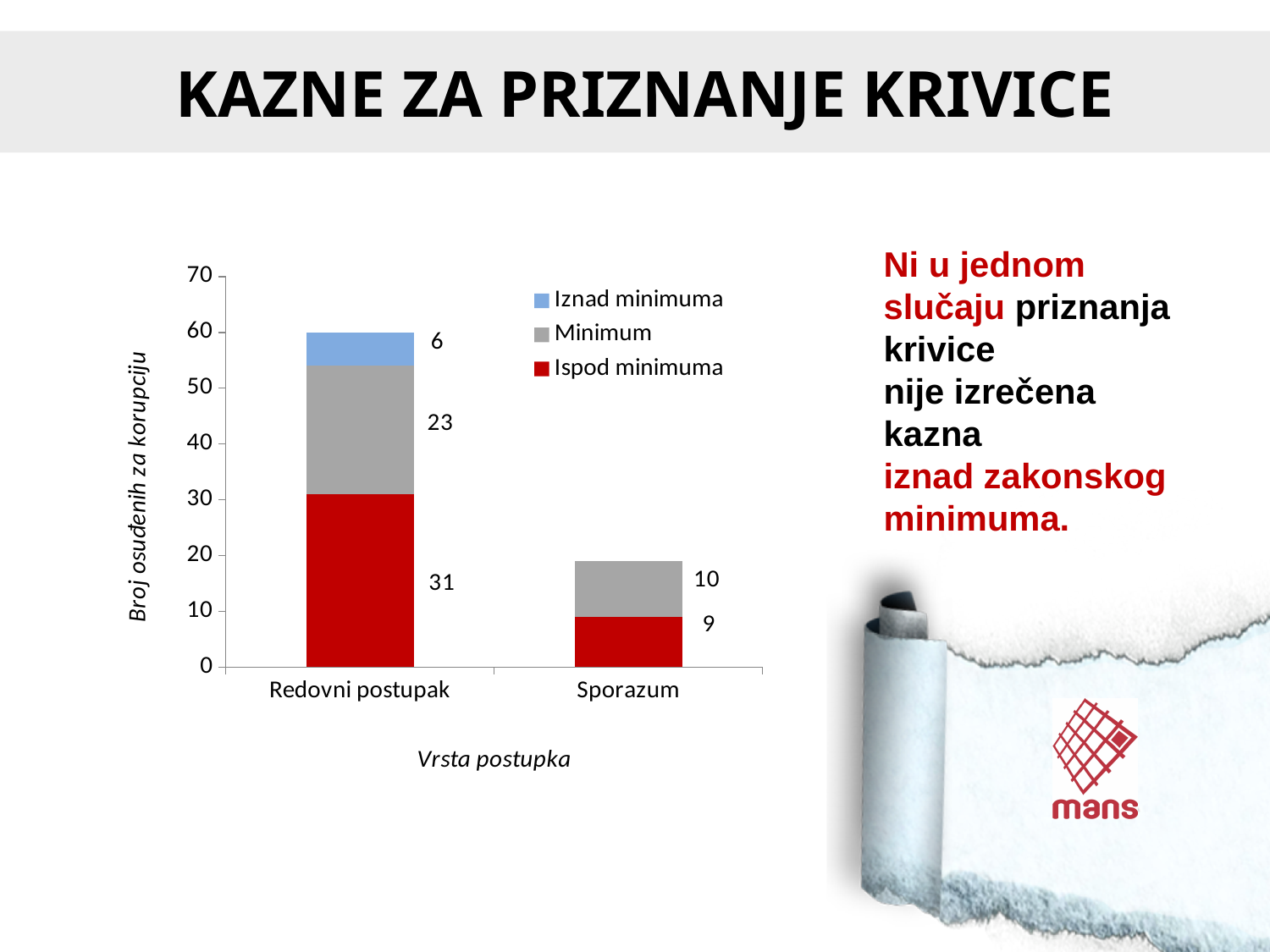
Which category has the higher Ispod minimuma value, Redovni postupak or Sporazum? Redovni postupak What is the difference between the Minimum values for Redovni postupak and Sporazum? 13 What kind of chart is shown on the slide? Stacked bar chart What is the value of Iznad minimuma for Redovni postupak? 6 How many series does the legend list? 3 How many categories are shown on the x axis? 2 What is the total of the stacked bar for Sporazum? 19 What is the value of Minimum for Sporazum? 10 What is the total of the stacked bar for Redovni postupak? 60 What is the value of Ispod minimuma for Redovni postupak? 31 What is the value of Ispod minimuma for Sporazum? 9 What is the label of the y axis? Broj osuđenih za korupciju